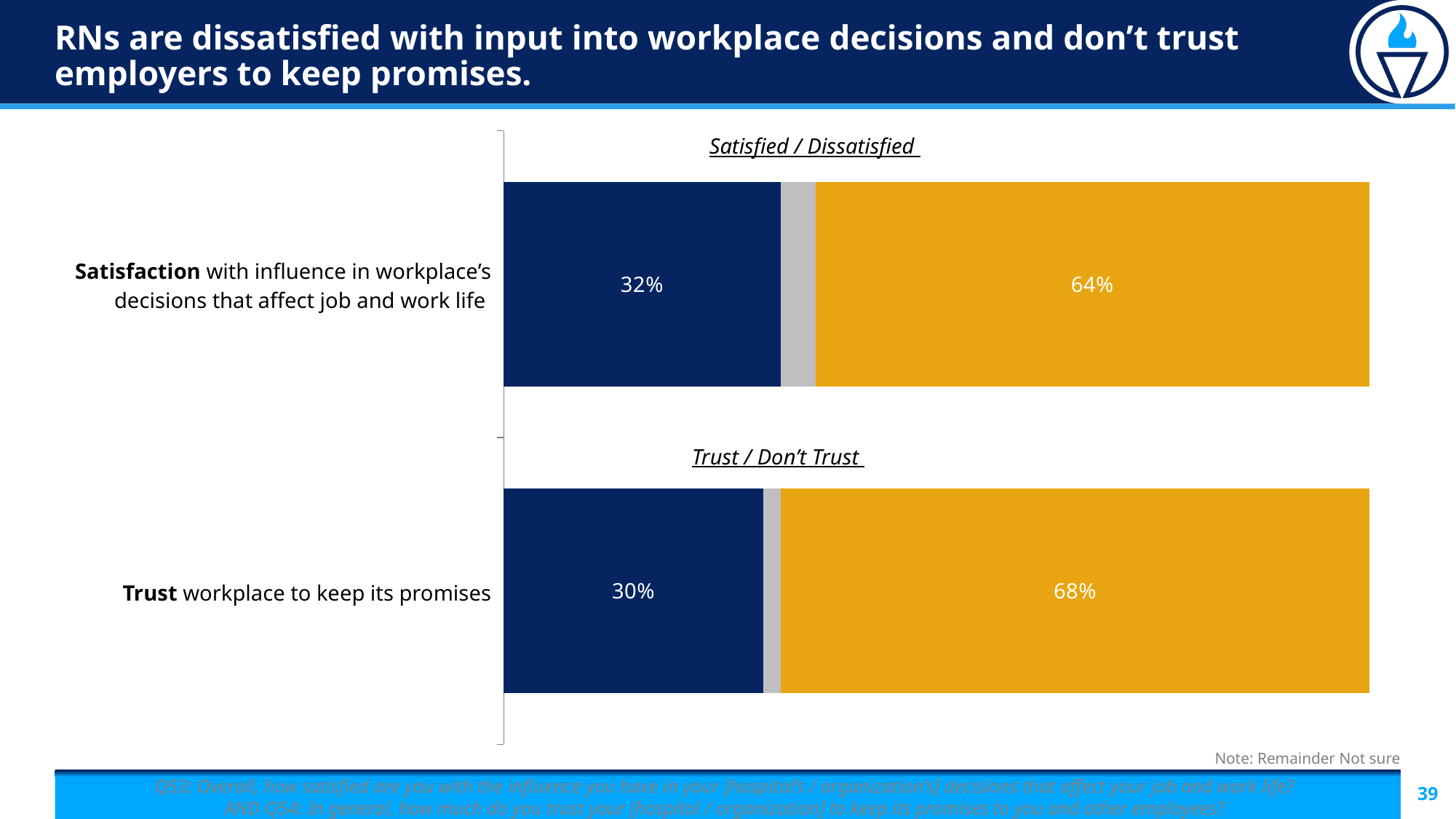
What percentage of RNs are satisfied with their influence in workplace decisions that affect job and work life? 32% How many bars (survey items) are shown in the chart? 2 Which of the four labelled values on the chart is the highest? 68% (Don't Trust) What is the difference between the don't trust and trust percentages for the workplace keeping its promises? 38% What percentage of RNs trust their workplace to keep its promises? 30% What percentage of RNs are dissatisfied with their influence in workplace decisions that affect job and work life? 64% Which of the four labelled values on the chart is the lowest? 30% (Trust) Which is larger: the percentage of RNs who are dissatisfied with influence in workplace decisions or the percentage who don't trust their workplace to keep promises? Don't trust workplace to keep promises Which is larger: the percentage satisfied with influence in workplace decisions or the percentage who trust the workplace to keep its promises? Satisfied with influence in workplace decisions What type of chart is shown on the slide? Stacked bar chart What percentage of RNs don't trust their workplace to keep its promises? 68% What is the difference between the dissatisfied and satisfied percentages for influence in workplace decisions? 32%